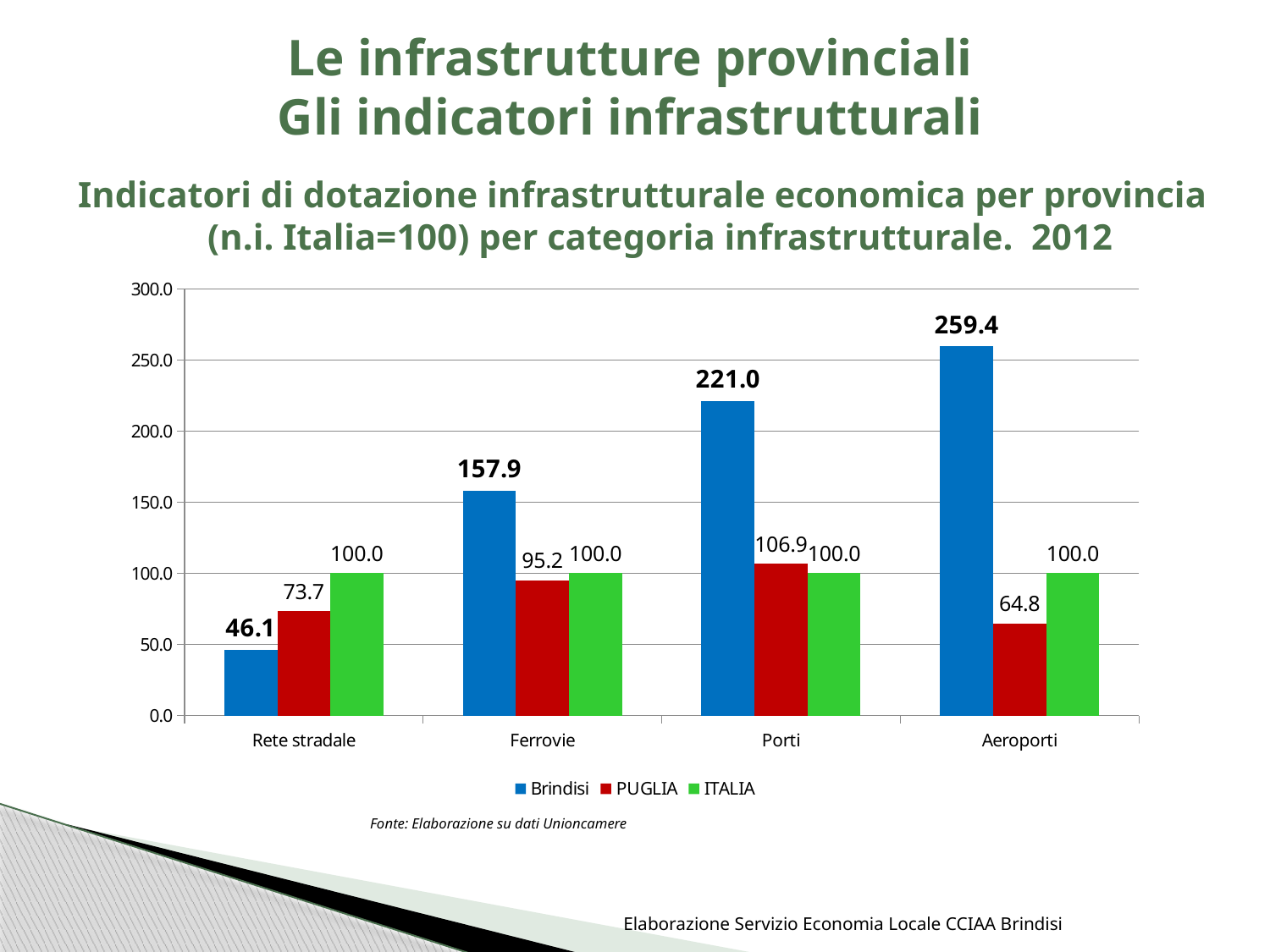
What is the difference between the Brindisi value and the PUGLIA value in the Porti category? 114.1 What is the value for PUGLIA in the Ferrovie category? 95.2 What is the value for Brindisi in the Rete stradale category? 46.1 What kind of chart is shown on the slide? Bar chart What is the value for Brindisi in the Aeroporti category? 259.4 Do the Brindisi values rise or fall from Rete stradale to Aeroporti? Rise Which category has the highest value for Brindisi? Aeroporti Which is larger in the Rete stradale category, the Brindisi value or the PUGLIA value? PUGLIA What colour are the bars for the ITALIA series? Green Which category has the lowest value for PUGLIA? Aeroporti How many series does the legend list? 3 How many categories are shown on the x axis? 4